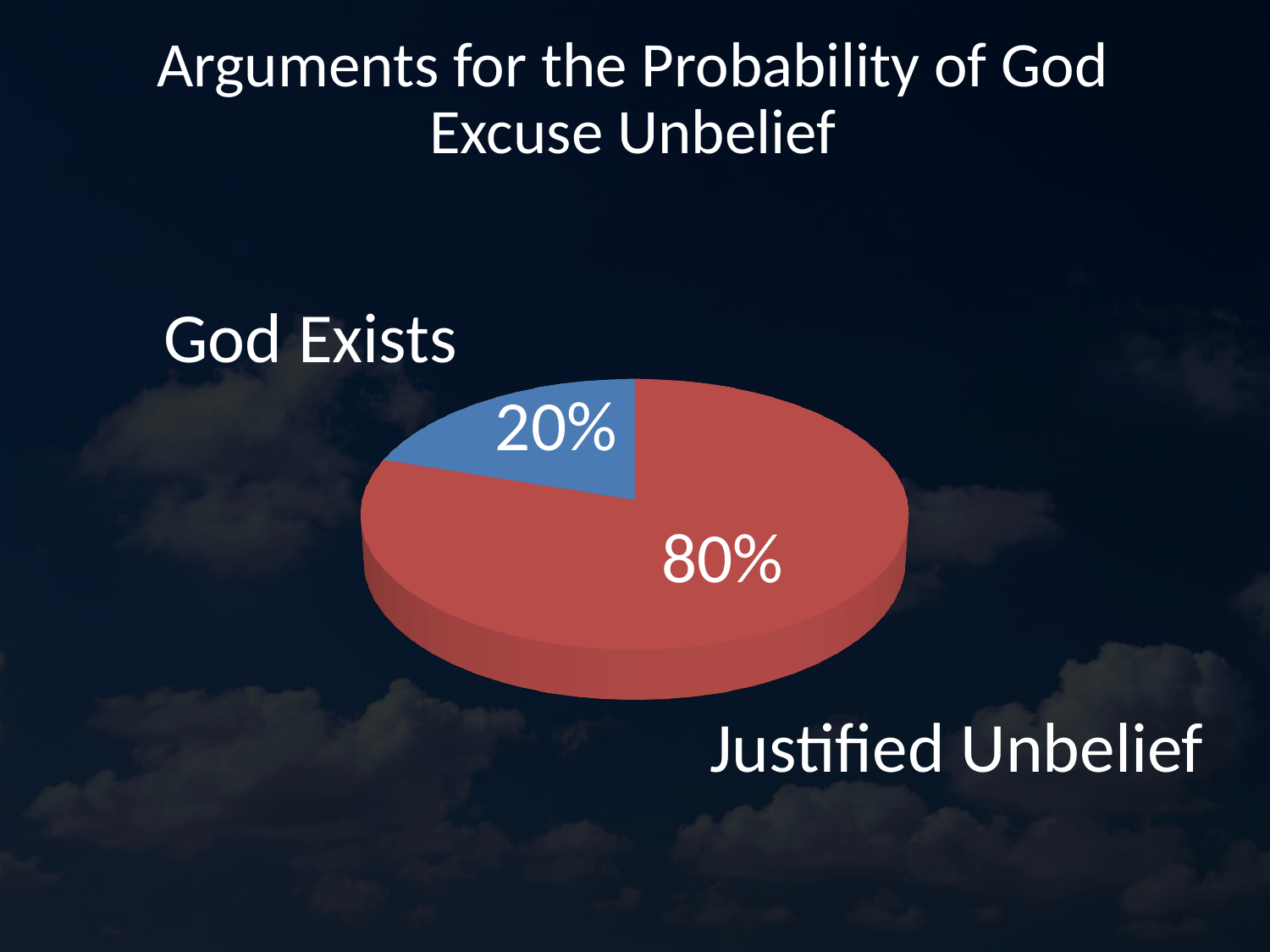
What colour is the God Exists slice? blue What share of the pie does the God Exists slice take? 20% How many slices does the pie chart have? 2 What colour is the Justified Unbelief slice? red What percentage is shown for the Justified Unbelief slice? 80% Which is larger, the God Exists slice or the Justified Unbelief slice? Justified Unbelief What is the difference between the Justified Unbelief and God Exists percentages? 60% Which slice is the smallest? God Exists What kind of chart is shown on the slide? pie chart What percentage is shown for the God Exists slice? 20% Which slice is the largest? Justified Unbelief